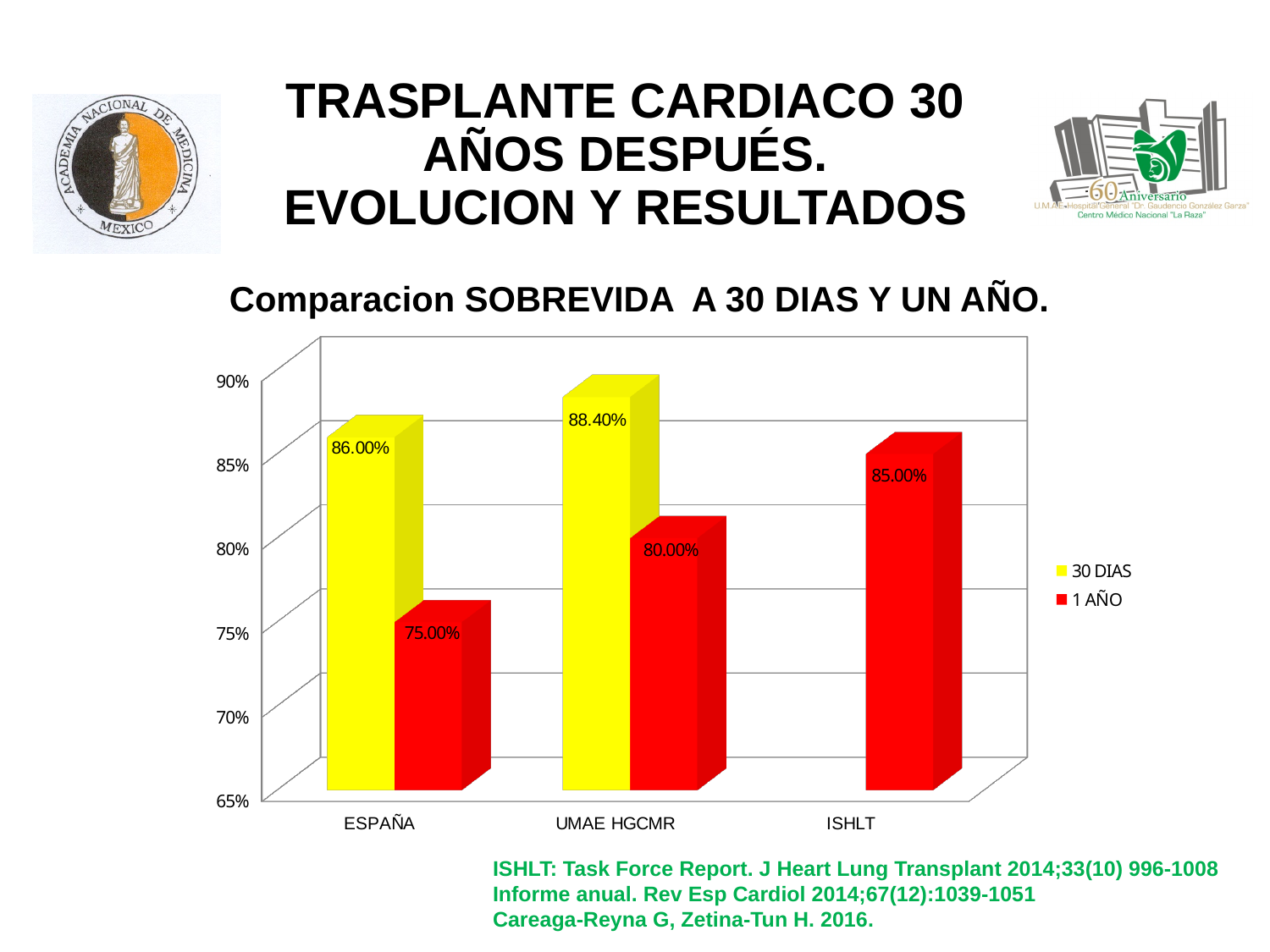
What is the 1 AÑO value for ISHLT? 85.00% Which category has the highest 30 DIAS value? UMAE HGCMR What is the difference between the 30 DIAS and 1 AÑO values for UMAE HGCMR? 8.40% What is the 1 AÑO value for UMAE HGCMR? 80.00% How many series does the legend list? 2 What is the 1 AÑO value for ESPAÑA? 75.00% What is the 30 DIAS value for ESPAÑA? 86.00% What kind of chart is shown on the slide? Bar chart Which category has the lowest 1 AÑO value? ESPAÑA Which is larger, the 1 AÑO value for ISHLT or the 1 AÑO value for UMAE HGCMR? ISHLT What colour represents the 1 AÑO series? Red How many categories are shown on the x axis? 3